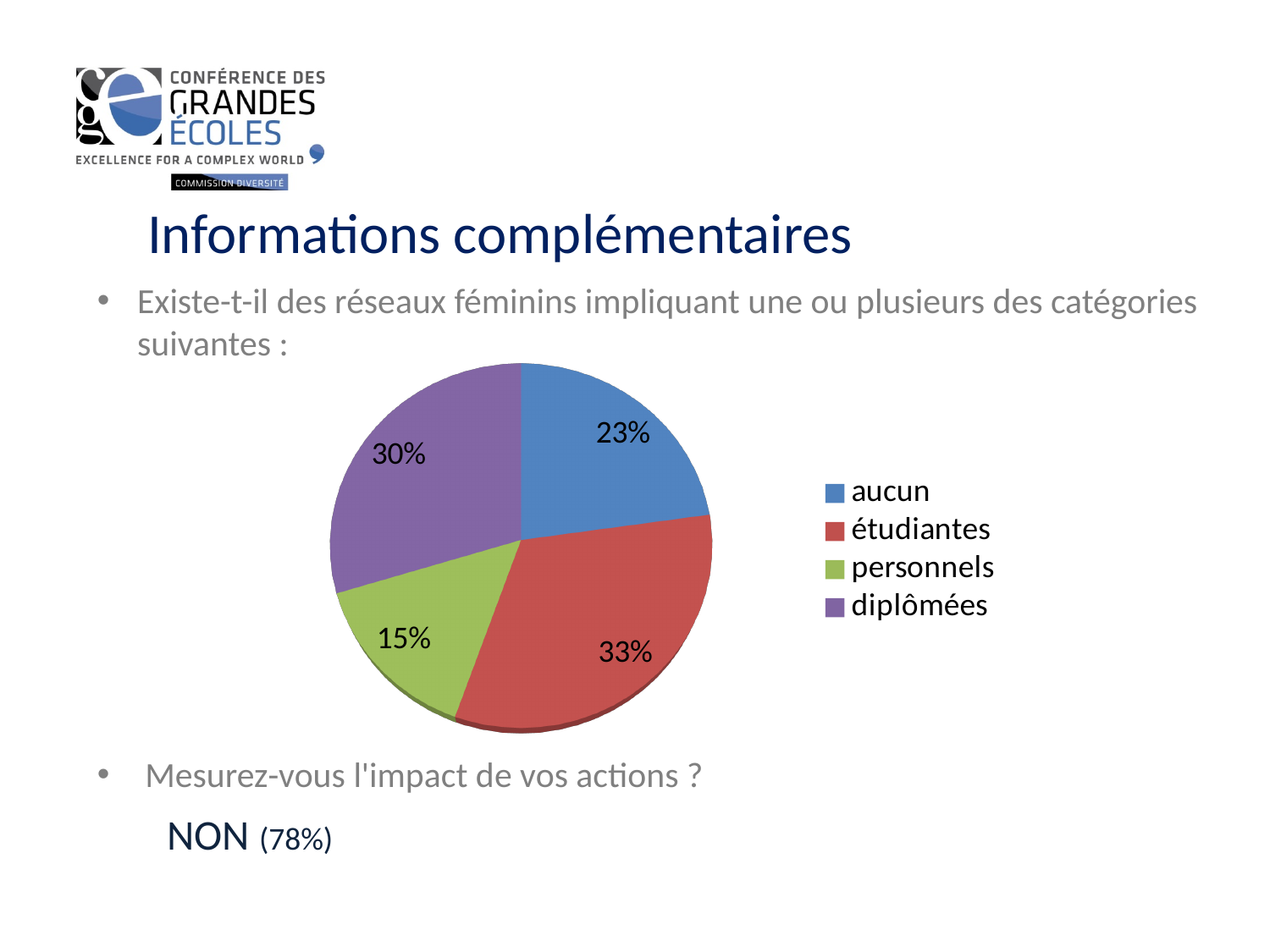
What share of the pie does the 'étudiantes' slice represent? 33% Which category has the largest slice of the pie? étudiantes What share of the pie does the 'personnels' slice represent? 15% What kind of chart is shown on the slide? pie chart Which category has the smallest slice of the pie? personnels What share of the pie does the 'diplômées' slice represent? 30% How many entries does the legend list? 4 What is the difference in percentage points between the 'étudiantes' slice and the 'personnels' slice? 18 How many categories does the pie chart have? 4 What colour is the 'diplômées' slice? purple Which slice is larger, 'diplômées' or 'aucun'? diplômées